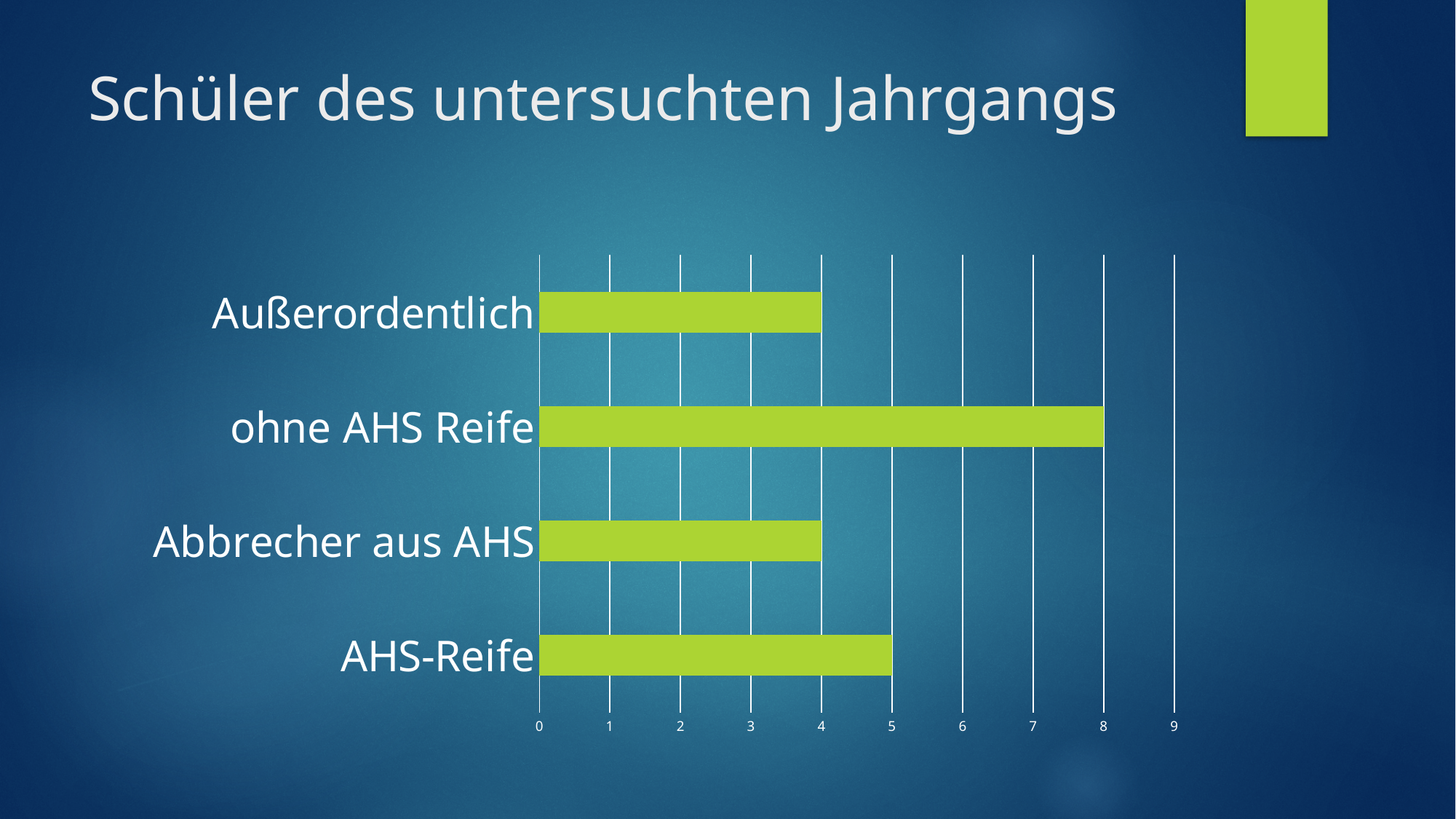
What is the value for AHS-Reife? 5 What is the difference between the values for ohne AHS Reife and Außerordentlich? 4 Which is larger, the value for AHS-Reife or the value for Abbrecher aus AHS? AHS-Reife What is the title of the slide containing the chart? Schüler des untersuchten Jahrgangs What is the difference between the values for ohne AHS Reife and AHS-Reife? 3 How many categories are shown in the chart? 4 Which category has the highest value? ohne AHS Reife What kind of chart is shown on the slide? bar chart What is the value for Abbrecher aus AHS? 4 Is the value for ohne AHS Reife greater or less than 6? greater What is the value for Außerordentlich? 4 What is the value for ohne AHS Reife? 8